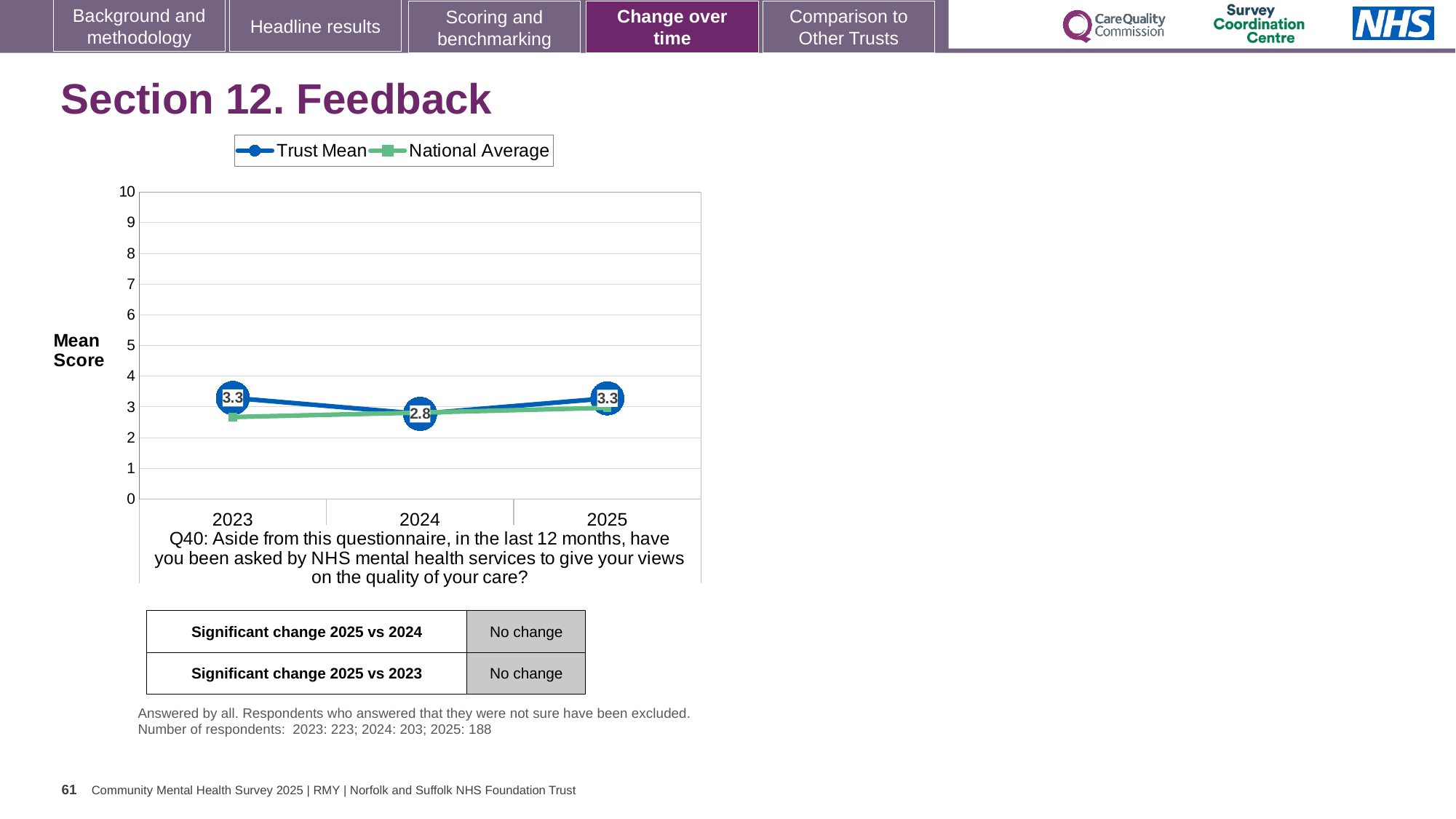
What is the Trust Mean value for 2024? 2.8 Does the Trust Mean rise or fall from 2024 to 2025? rise What is the difference between the Trust Mean in 2023 and in 2024? 0.5 What is the Trust Mean value for 2023? 3.3 How many series does the legend list? 2 What is the label on the y axis of the chart? Mean Score Which is larger, the Trust Mean for 2024 or for 2025? 2025 Is the National Average value for 2023 greater or less than 3? less How many years are shown on the x axis? 3 In which year is the Trust Mean lowest? 2024 What is the Trust Mean value for 2025? 3.3 What kind of chart is shown on the slide? line chart